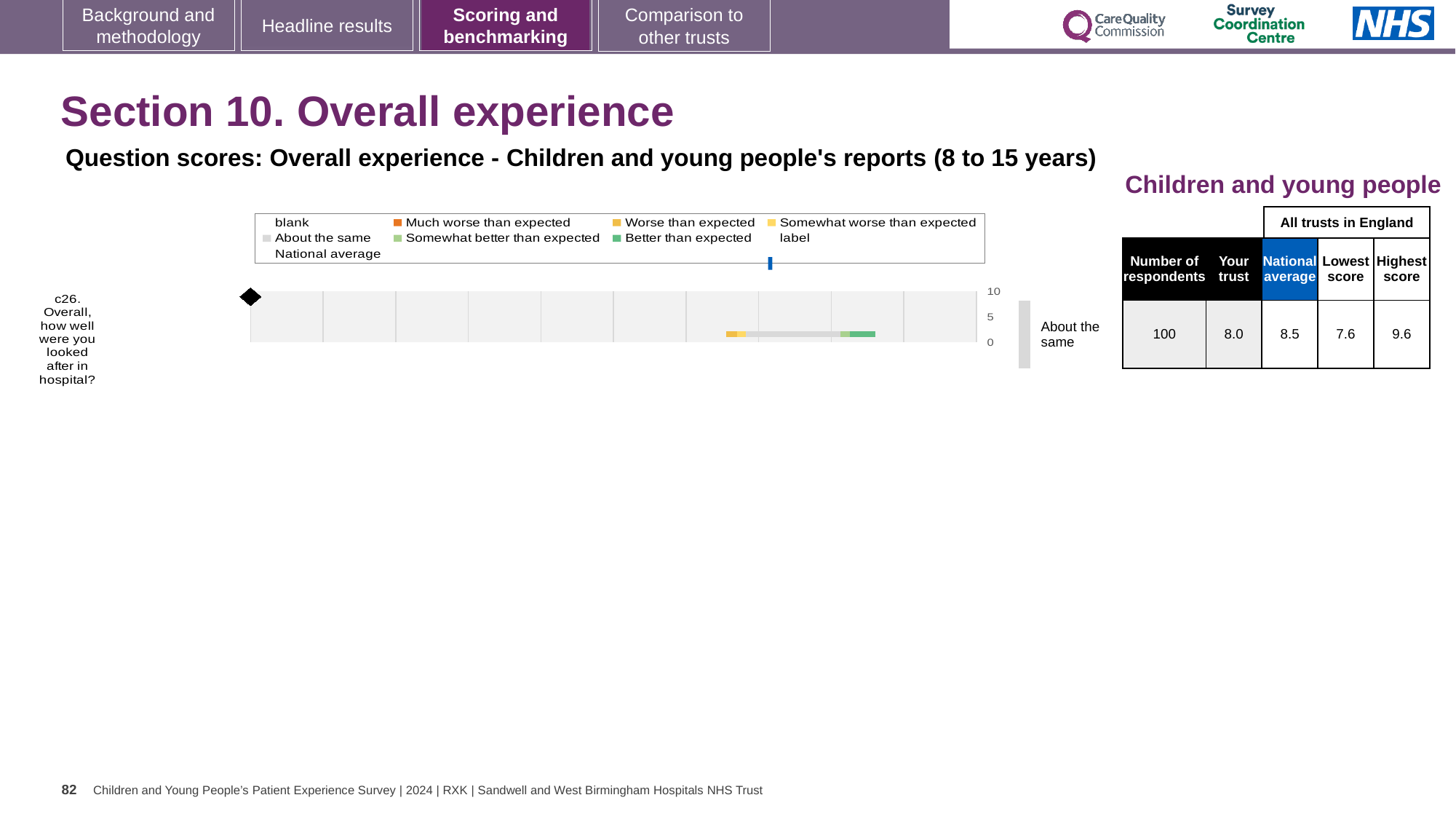
What is the difference between the national average and the 'Your trust' score for c26? 0.5 What is the 'Your trust' score for c26 'Overall, how well were you looked after in hospital?'? 8.0 What benchmark category is the trust's c26 score placed in? About the same Which is larger for c26, the 'Your trust' score or the national average? National average What kind of chart is used to show the score for question c26? bar chart What is the lowest score among all trusts in England for c26? 7.6 What is the national average score for c26? 8.5 What is the highest score among all trusts in England for c26? 9.6 How many respondents answered question c26? 100 What is the difference between the highest and lowest trust scores for c26? 2.0 How many survey questions are plotted on the chart? 1 What is the maximum value shown on the chart's score axis? 10